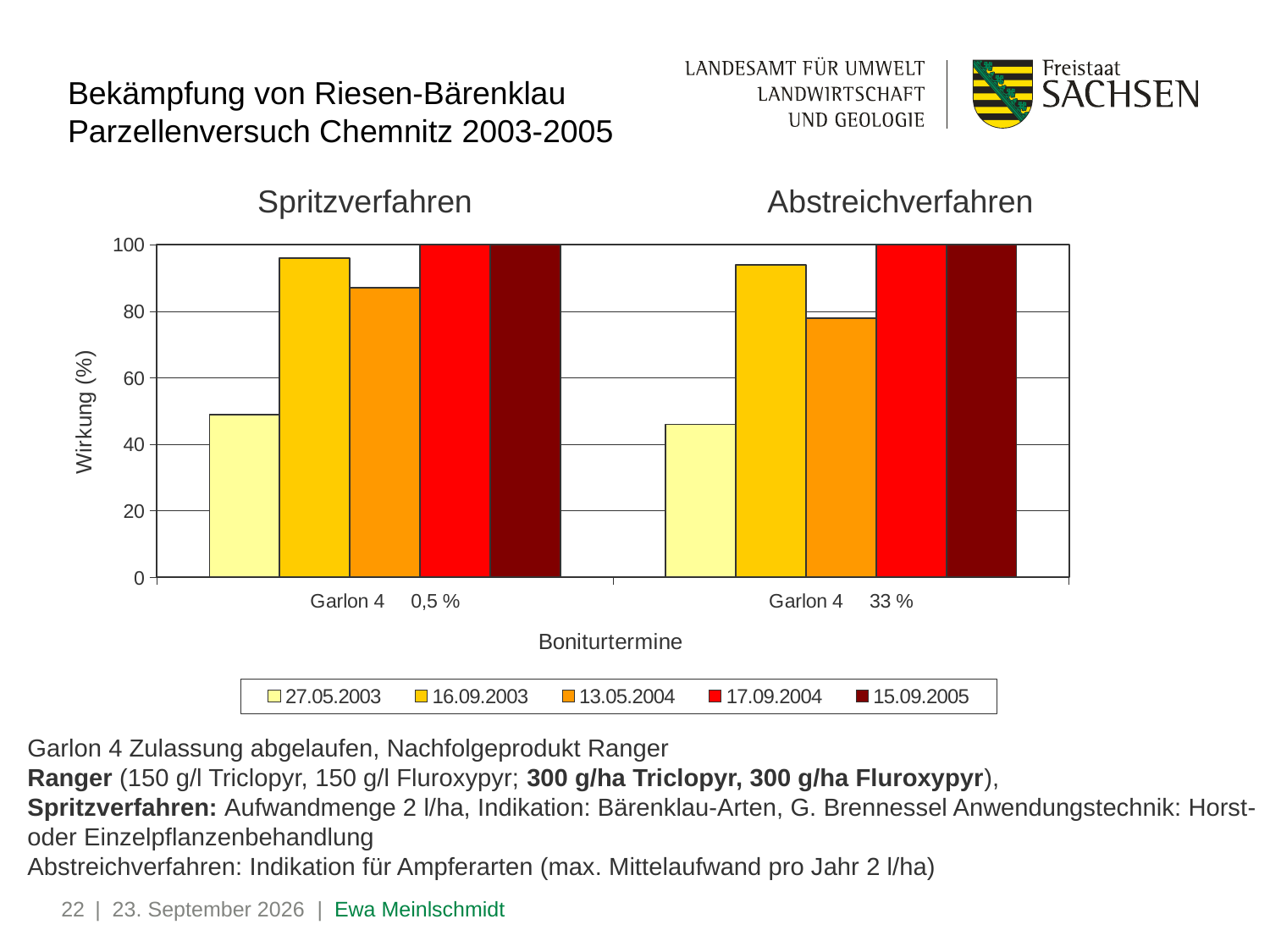
Is the value for 27.05.2003 in the Spritzverfahren group greater or less than 60? less Is the value for 27.05.2003 in the Abstreichverfahren group greater or less than 40? greater How many categories (groups of bars) are shown on the x axis? 2 How many series does the legend list? 5 Is the value for 16.09.2003 in the Spritzverfahren group greater or less than 80? greater What is the value for 15.09.2005 in the Abstreichverfahren (Garlon 4 33 %) group? 100 What kind of chart is shown on the slide? bar chart For 13.05.2004, which group has the larger value, Spritzverfahren or Abstreichverfahren? Spritzverfahren Which date has the lowest value in the Spritzverfahren (Garlon 4 0,5 %) group? 27.05.2003 What is the label of the y axis? Wirkung (%) What is the value for 17.09.2004 in the Spritzverfahren (Garlon 4 0,5 %) group? 100